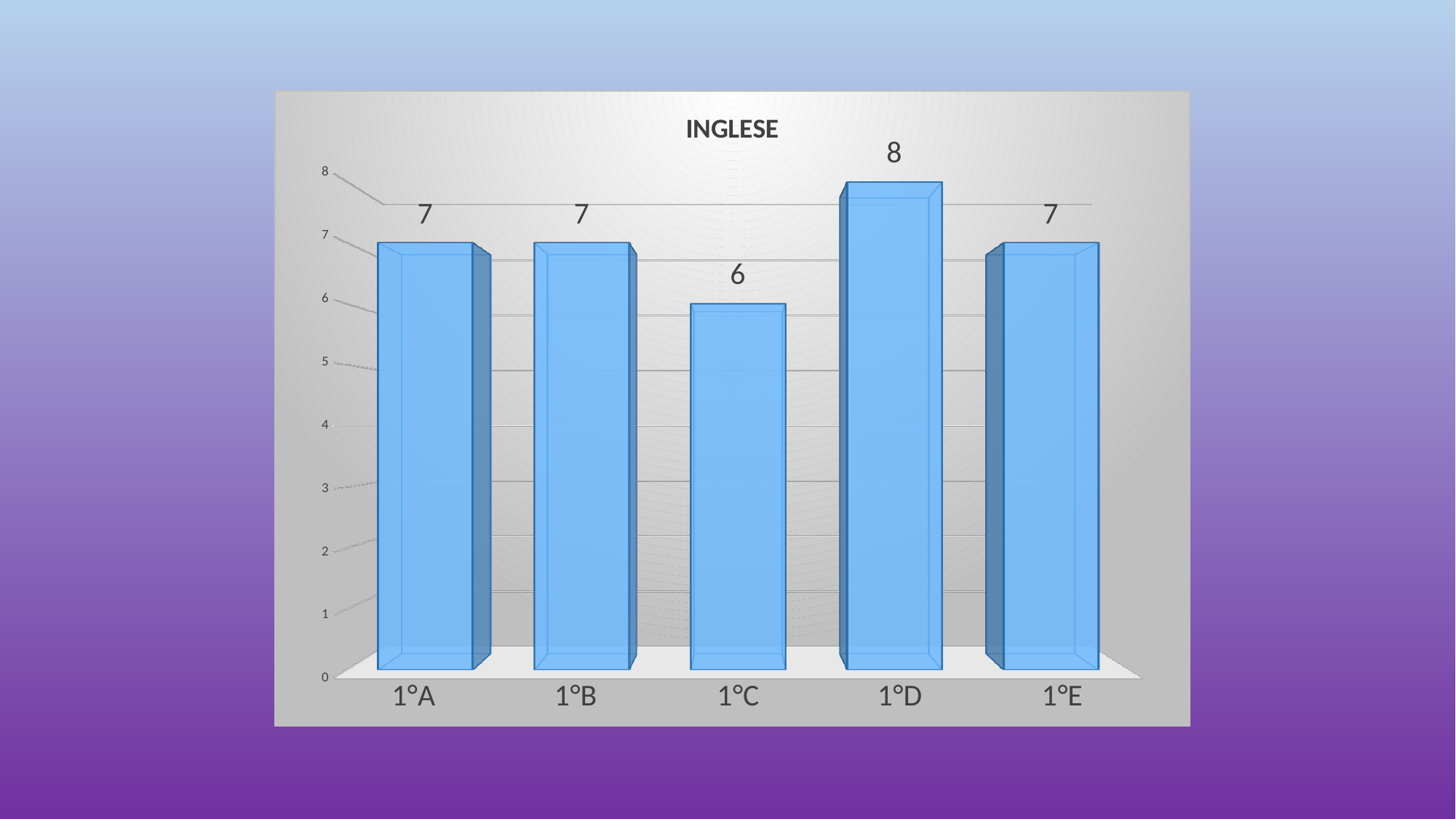
How many categories are shown on the x axis? 5 What kind of chart is shown on the slide? bar chart What is the value for 1°E? 7 What is the value for 1°A? 7 What is the value for 1°C? 6 Which category has the highest value? 1°D What is the difference between the values for 1°D and 1°C? 2 Which is larger, the value for 1°B or the value for 1°C? 1°B What is the value for 1°D? 8 Which category has the lowest value? 1°C What is the title of the chart? INGLESE Is the value for 1°D greater or less than 7? greater